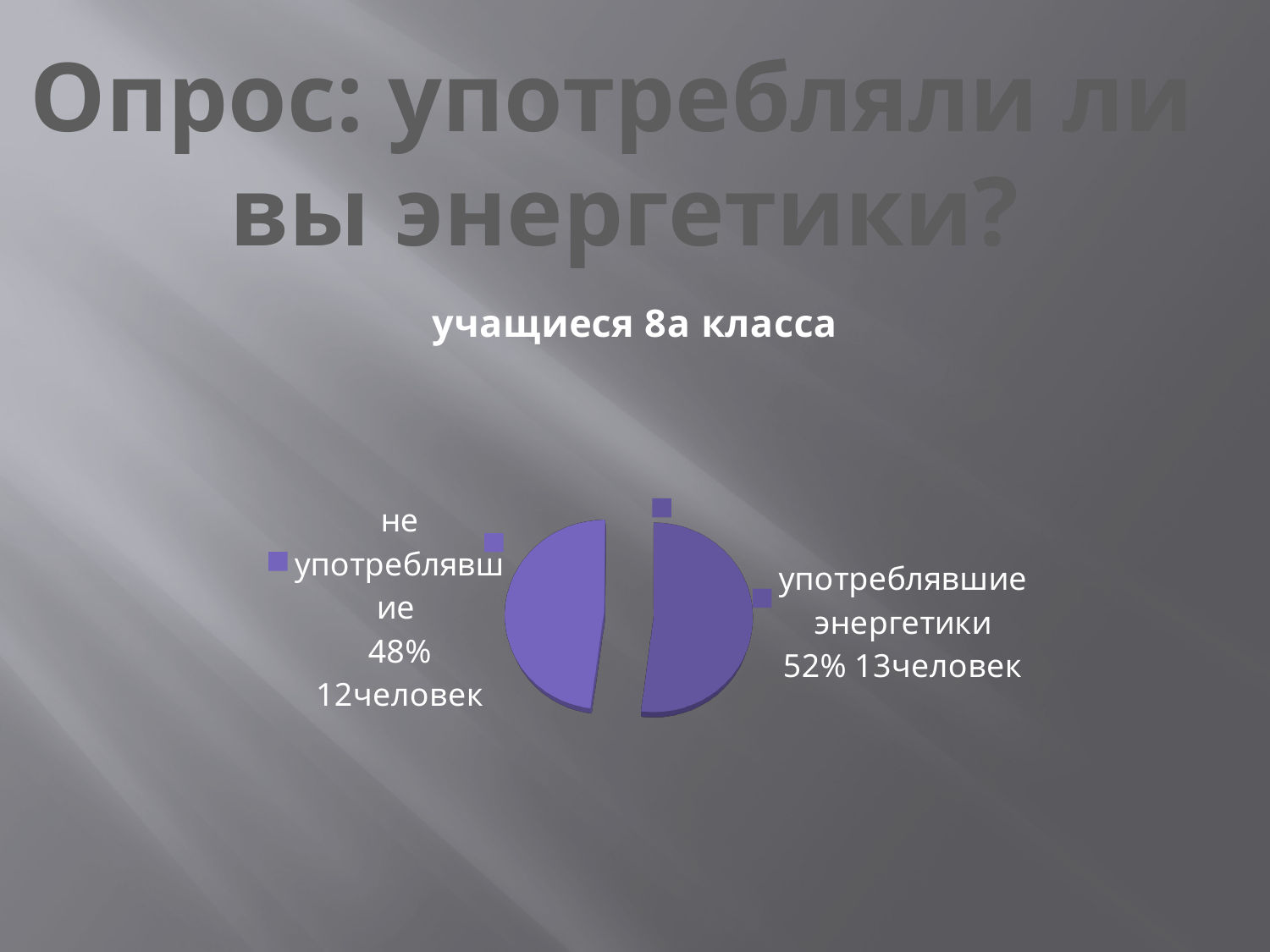
What is the total number of people across both slices? 25 What kind of chart is shown on the slide? pie chart Which slice is the largest? употреблявшие энергетики What is the difference in percentage points between the "употреблявшие энергетики" and "не употреблявшие" slices? 4 How many people are in the "не употреблявшие" slice? 12человек What share of the pie is labelled "не употреблявшие"? 48% What share of the pie is labelled "употреблявшие энергетики"? 52% How many people are in the "употреблявшие энергетики" slice? 13человек Which slice is the smallest? не употреблявшие How many slices does the pie chart have? 2 Which is larger: the share for "употреблявшие энергетики" or for "не употреблявшие"? употреблявшие энергетики What is the title of the chart? учащиеся 8а класса